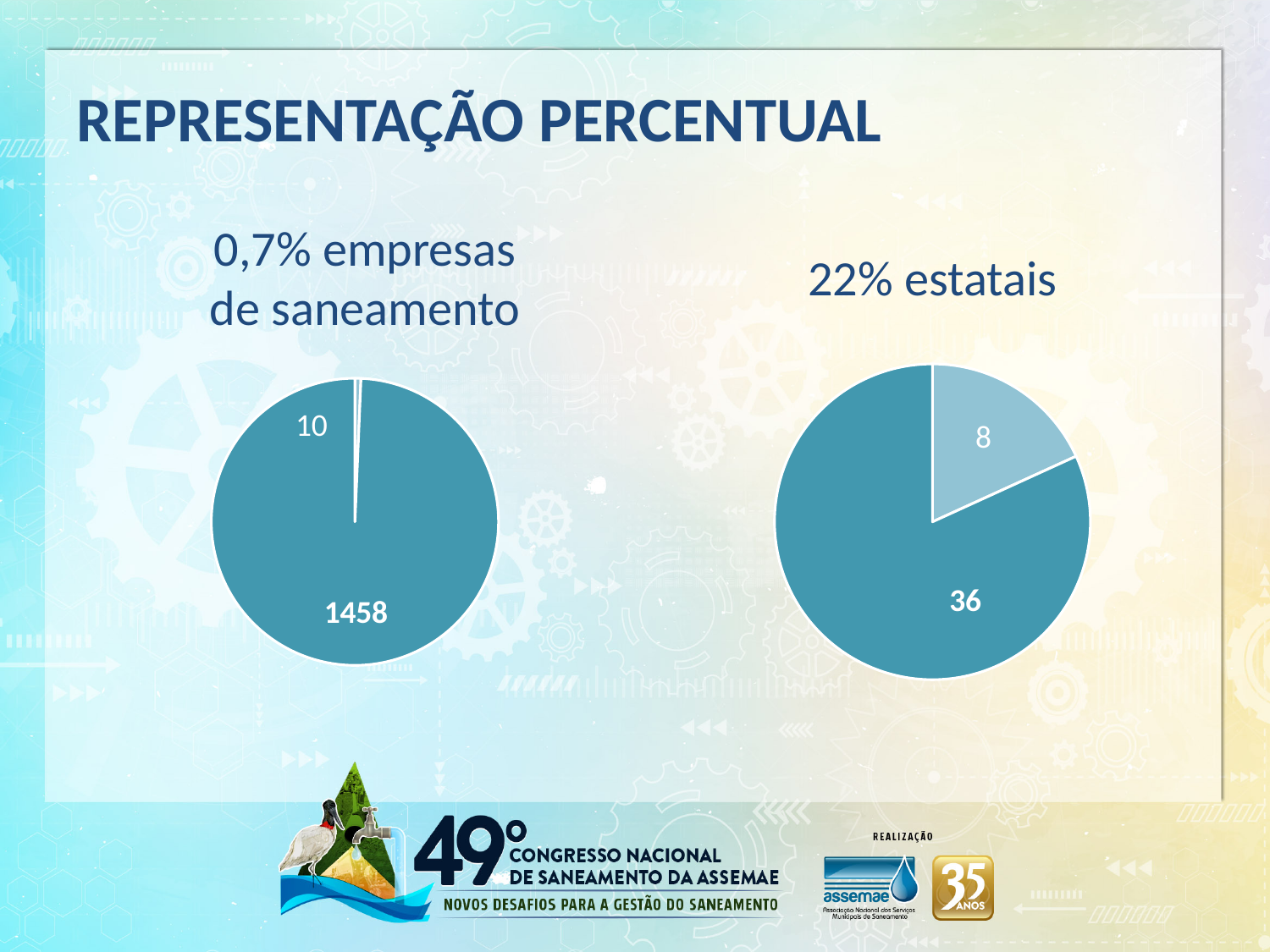
In the left pie chart (0,7% empresas de saneamento), what is the difference between the two slice values? 1448 What is the title of the slide? REPRESENTAÇÃO PERCENTUAL In the right pie chart (22% estatais), what is the total of the two slices? 44 In the left pie chart (0,7% empresas de saneamento), what is the value of the small slice? 10 What type of charts are shown on the slide? Pie charts In the left pie chart (0,7% empresas de saneamento), what is the total of the two slices? 1468 In the right pie chart (22% estatais), what is the value of the large slice? 36 How many pie charts are on the slide? 2 In the right pie chart (22% estatais), which slice is larger, the one labelled 8 or the one labelled 36? 36 In the right pie chart (22% estatais), what is the value of the small light-blue slice? 8 In the right pie chart (22% estatais), what is the difference between the two slice values? 28 In the left pie chart (0,7% empresas de saneamento), what is the value of the large slice? 1458